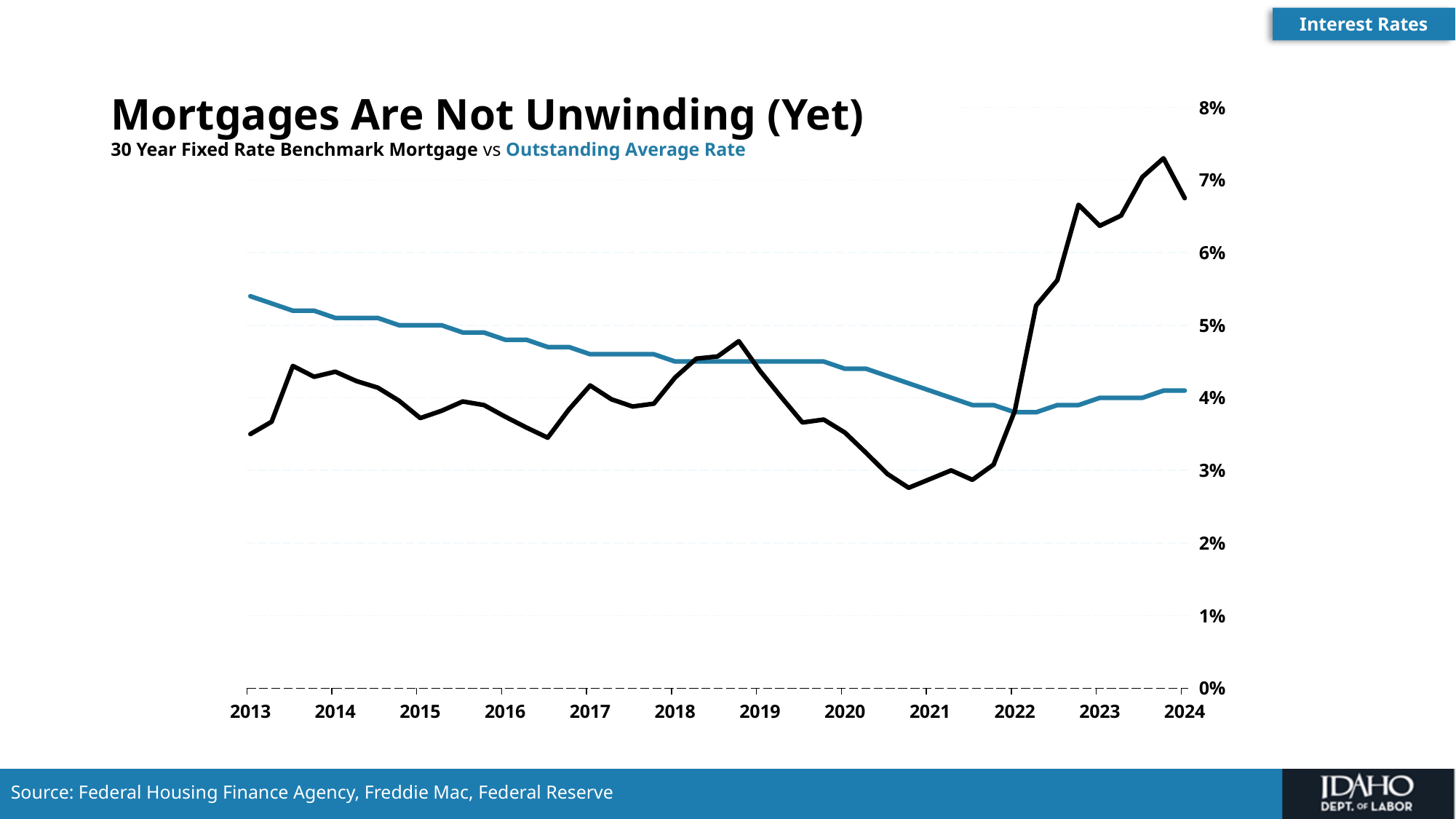
How many year labels are shown on the x axis? 12 Is the Outstanding Average Rate at the start of 2013 greater or less than 5%? greater Is the Outstanding Average Rate at 2022 greater or less than 4%? less Is the 30 Year Fixed Rate Benchmark Mortgage value at the start of 2013 greater or less than 4%? less Which series is drawn in blue? Outstanding Average Rate What is the title of the chart? Mortgages Are Not Unwinding (Yet) What kind of chart is shown on the slide? Line chart At 2024, which series has the higher value: 30 Year Fixed Rate Benchmark Mortgage or Outstanding Average Rate? 30 Year Fixed Rate Benchmark Mortgage How many series are plotted on the chart? 2 Does the Outstanding Average Rate line rise or fall from 2013 to 2022? Fall At 2013, which series has the higher value: 30 Year Fixed Rate Benchmark Mortgage or Outstanding Average Rate? Outstanding Average Rate